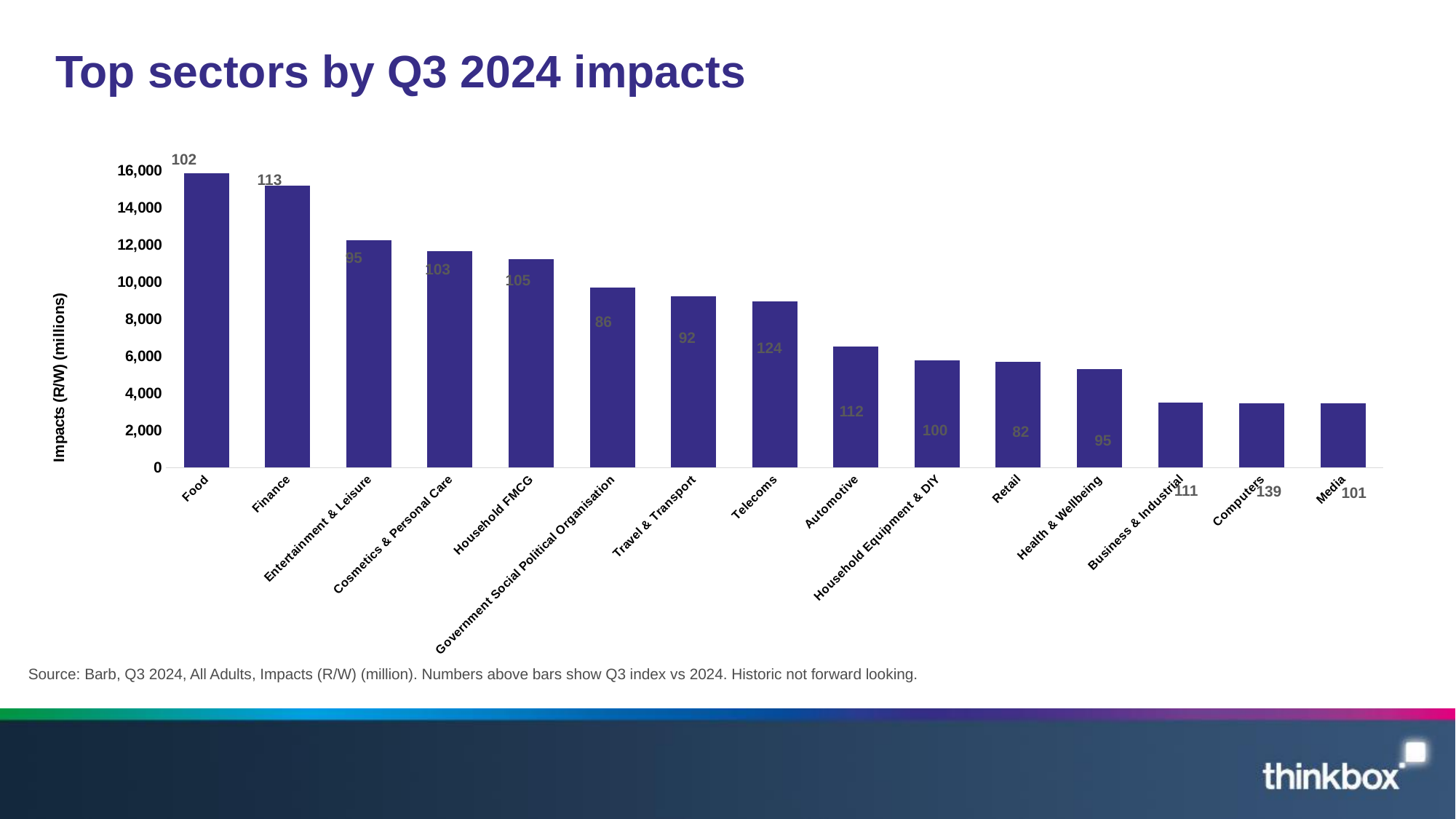
What Q3 index vs 2024 is printed for Telecoms? 124 Is the impacts value for Food greater or less than 14,000? greater What kind of chart is shown on the slide? bar chart Which has higher impacts, Telecoms or Automotive? Telecoms Which sector has the highest Q3 2024 impacts? Food Do the impacts values rise or fall moving from left to right along the x axis? fall Is the impacts value for Government Social Political Organisation greater or less than 10,000? less What Q3 index vs 2024 is printed for Computers? 139 Is the impacts value for Media greater or less than 4,000? less What is the title of the vertical axis? Impacts (R/W) (millions) How many sectors are plotted on the chart? 15